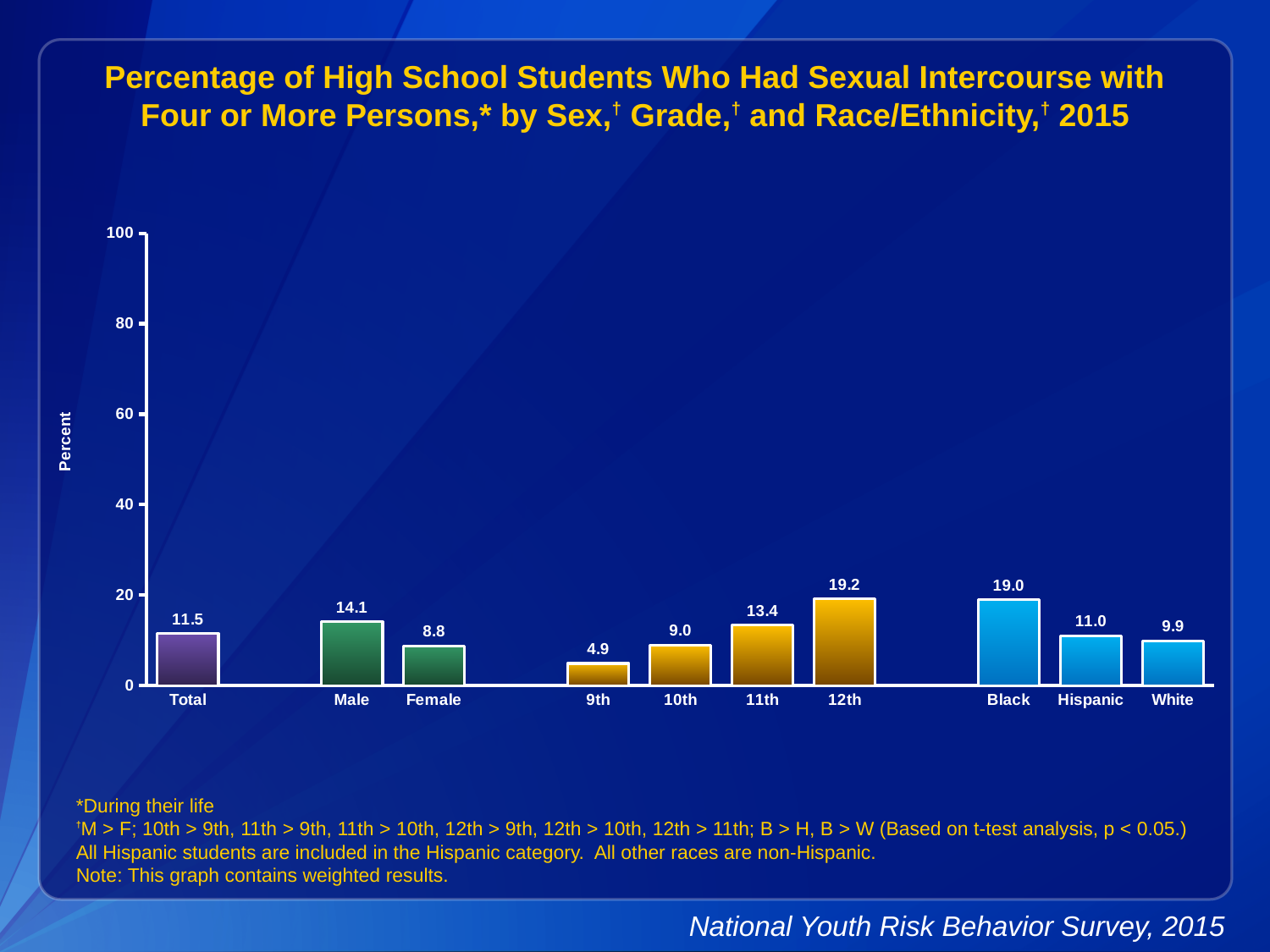
What kind of chart is shown? bar chart What is the value for Total? 11.5 Which category has the lowest value? 9th What is the difference between the Male and Female values? 5.3 What is the value for Female? 8.8 What is the value for 9th grade? 4.9 Is the value for 11th grade greater or less than 20? less How many bars are shown in the chart? 10 Which category has the highest value? 12th What is the value for Hispanic? 11.0 Which is larger, the value for Black or the value for White? Black Do the values rise or fall from 9th grade to 12th grade? rise